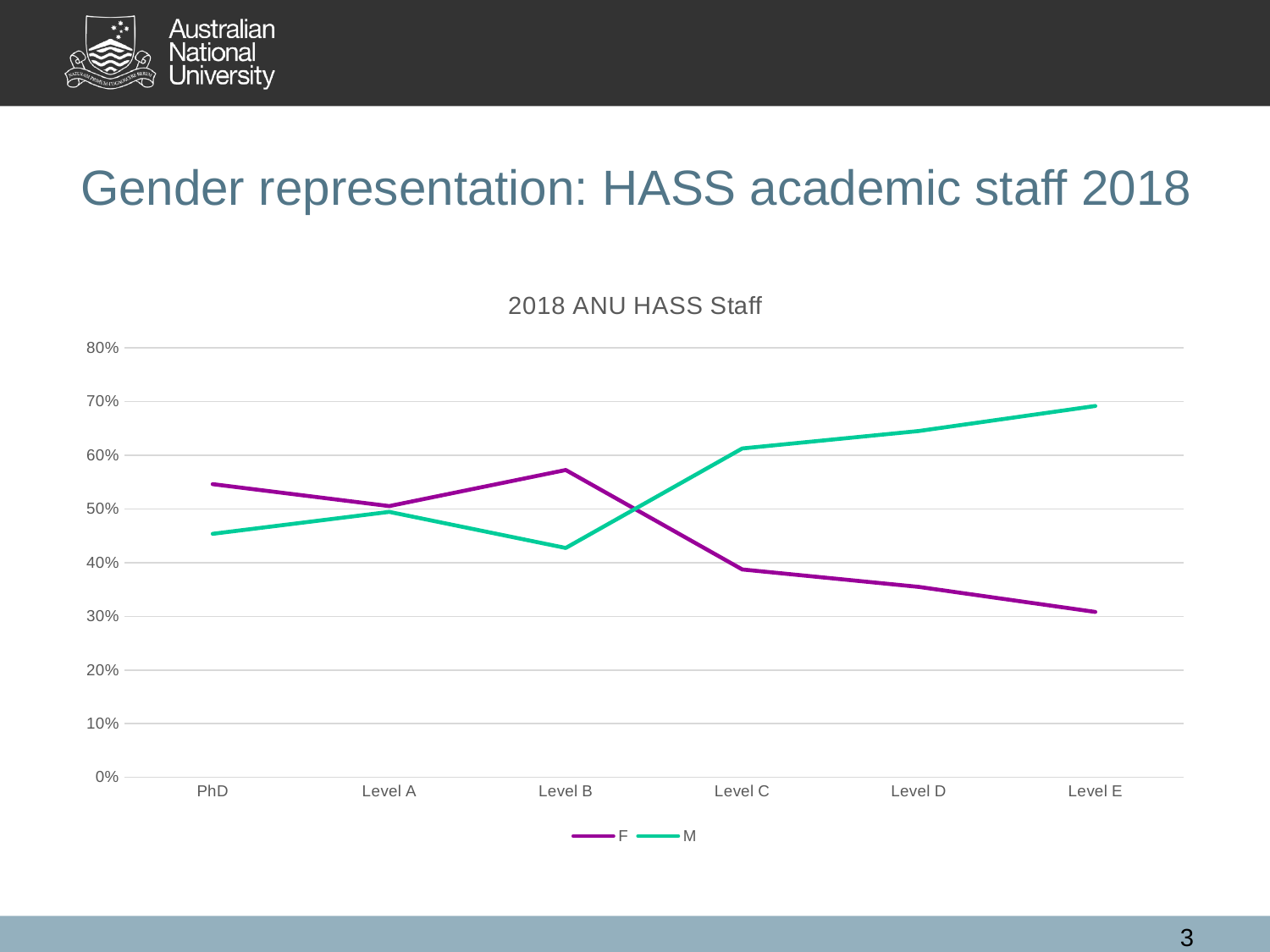
Which category has the highest value for the M series? Level E What is the title of the chart? 2018 ANU HASS Staff Which category has the highest value for the F series? Level B Does the M series generally rise or fall from Level B to Level E? rise What type of chart is shown on the slide? line chart Is the value for F at Level C greater or less than 40%? less At Level D, which series has the larger value, F or M? M How many categories are shown on the x axis? 6 Is the value for M at Level E greater or less than 60%? greater How many series does the legend list? 2 Is the value for M at Level B greater or less than 50%? less Which category has the lowest value for the F series? Level E